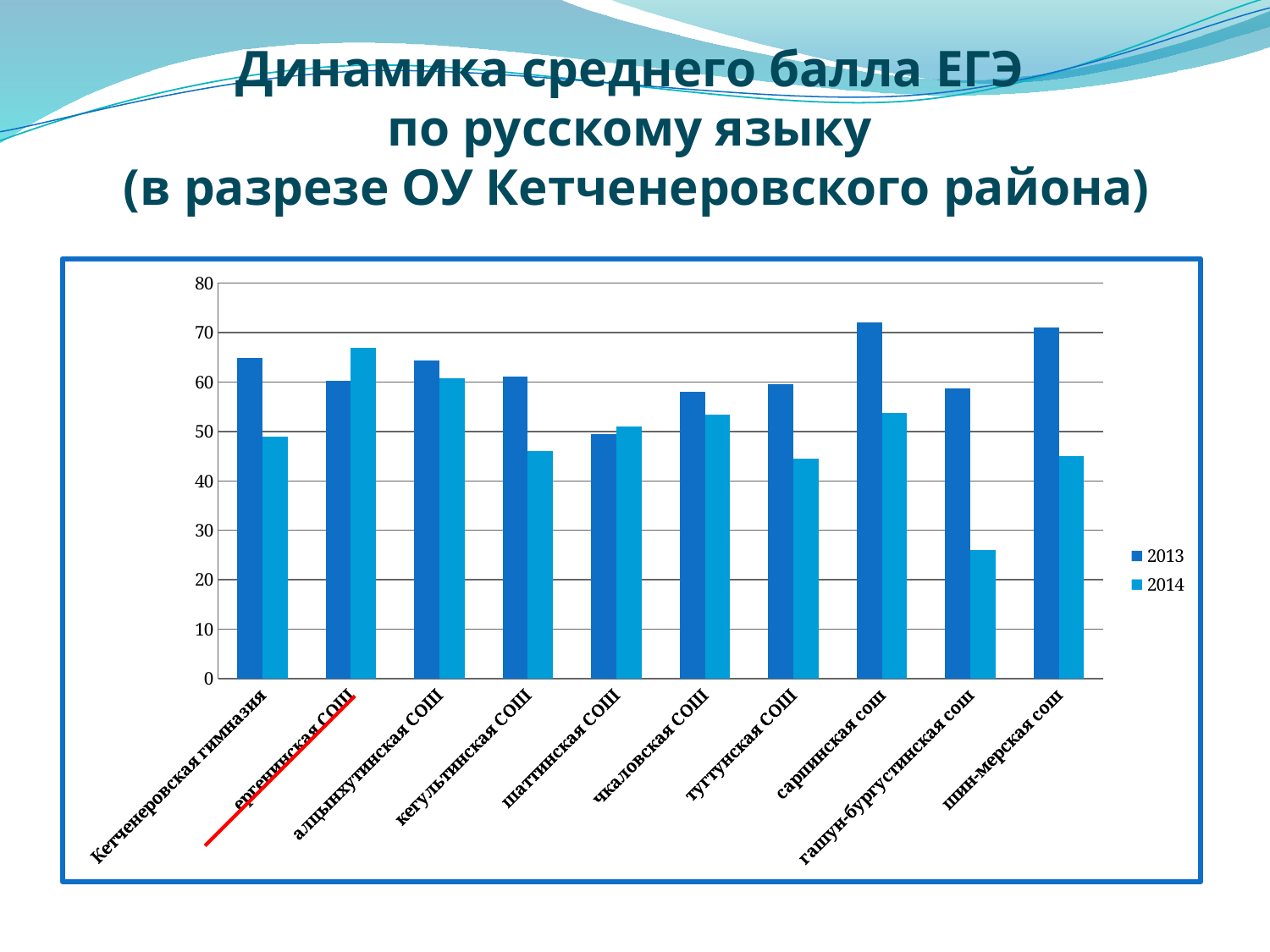
Is the 2013 value for сарпинская сош greater or less than 70? greater Which school has the lowest value for the 2013 series? шаттинская СОШ Which school has the highest value for the 2014 series? ергенинская СОШ What kind of chart is shown on the slide? bar chart How many schools (categories) are shown on the x axis of the chart? 10 For Кетченеровская гимназия, which year has the larger value, 2013 or 2014? 2013 Is the 2014 value for тугтунская СОШ greater or less than 50? less For ергенинская СОШ, which year has the larger value, 2013 or 2014? 2014 What are the two entries listed in the chart's legend? 2013 and 2014 Which school has the lowest value for the 2014 series? гашун-бургустинская сош Is the 2014 value for гашун-бургустинская сош greater or less than 30? less How many series does the chart's legend list? 2